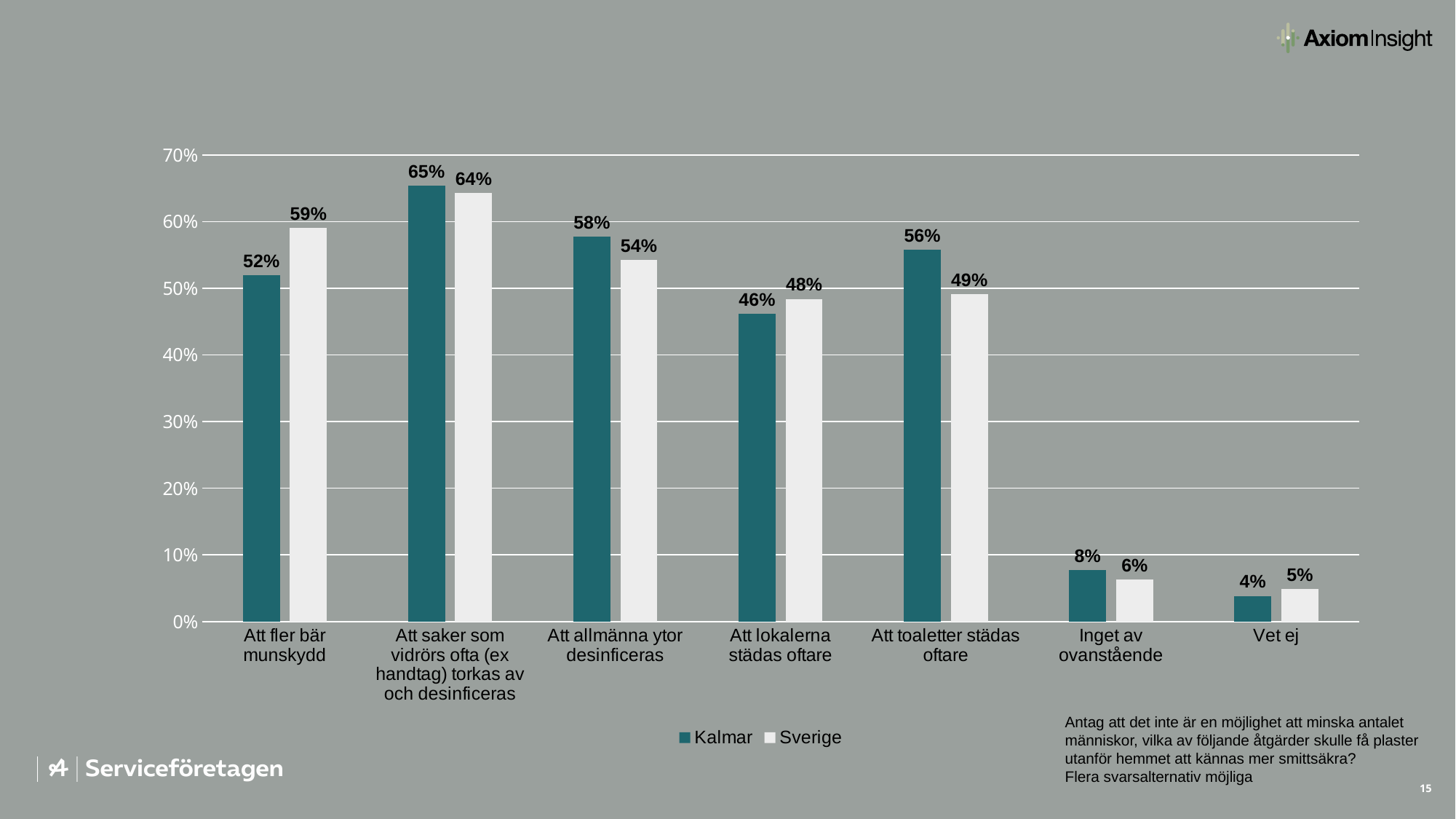
Which category has the lowest Sverige value? Vet ej What is the Kalmar value for "Att fler bär munskydd"? 52% For "Att allmänna ytor desinficeras", which is larger: Kalmar or Sverige? Kalmar What is the difference between the Kalmar and Sverige values for "Att fler bär munskydd"? 7% Which category has the highest Kalmar value? Att saker som vidrörs ofta (ex handtag) torkas av och desinficeras How many series does the legend list? 2 For "Att lokalerna städas oftare", which is larger: Kalmar or Sverige? Sverige Which series is shown in dark teal? Kalmar How many categories are shown on the x axis? 7 What is the Kalmar value for "Vet ej"? 4% What is the Sverige value for "Att toaletter städas oftare"? 49% What kind of chart is shown on the slide? Bar chart